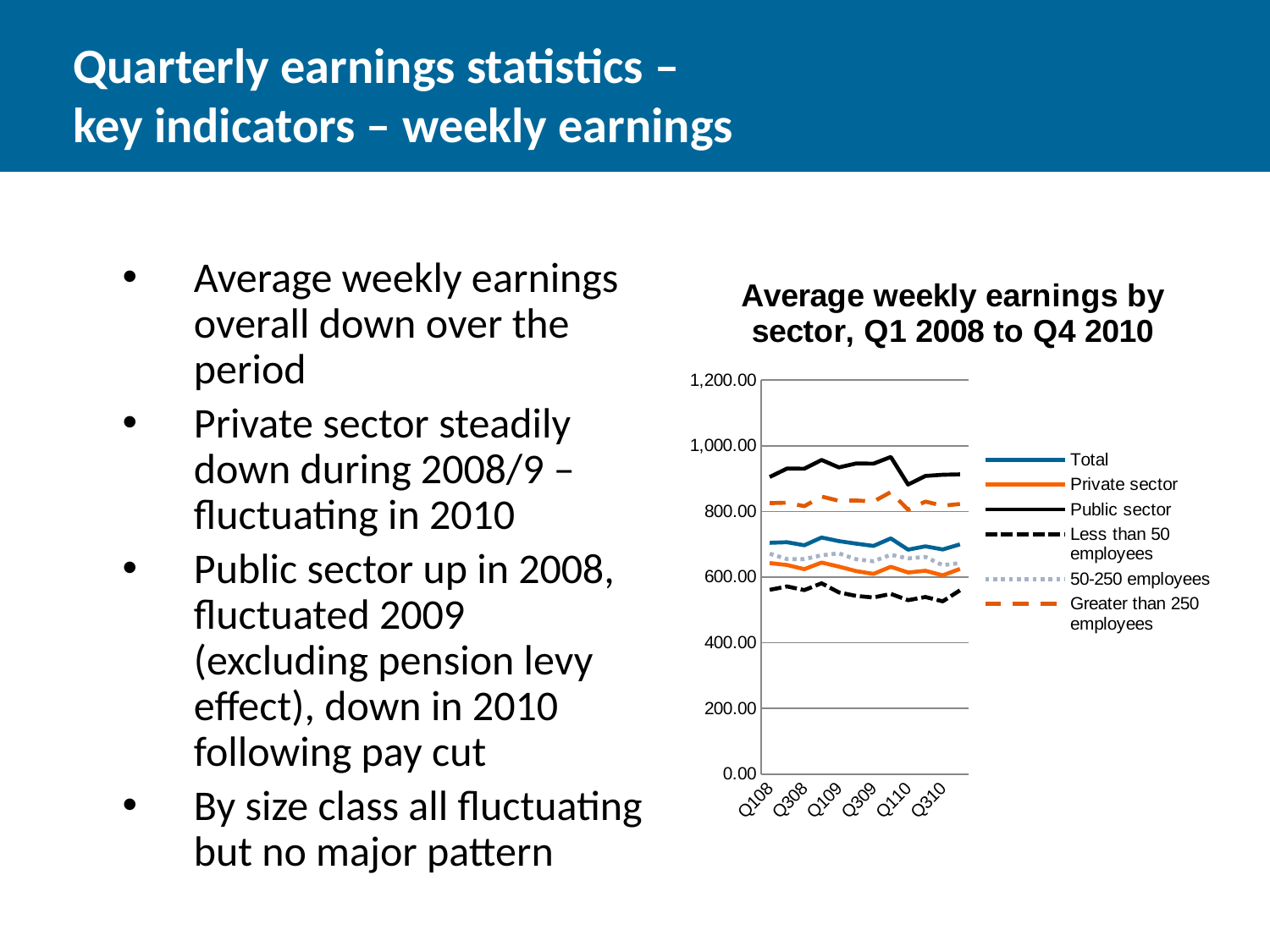
Is the value for Total at Q109 greater or less than 600? greater What kind of chart is shown on the slide? Line chart Which series is plotted as the highest line throughout the chart? Public sector How many quarter labels are shown on the x axis? 6 Which series is plotted as the lowest line throughout the chart? Less than 50 employees Is the value for Public sector at Q108 greater or less than 800? greater At Q110, which is larger: the Public sector value or the Private sector value? Public sector What is the title of the chart? Average weekly earnings by sector, Q1 2008 to Q4 2010 Is the value for Private sector at Q308 greater or less than 800? less How many series does the chart's legend list? 6 Does the Private sector line generally rise or fall from Q108 to Q309? Fall